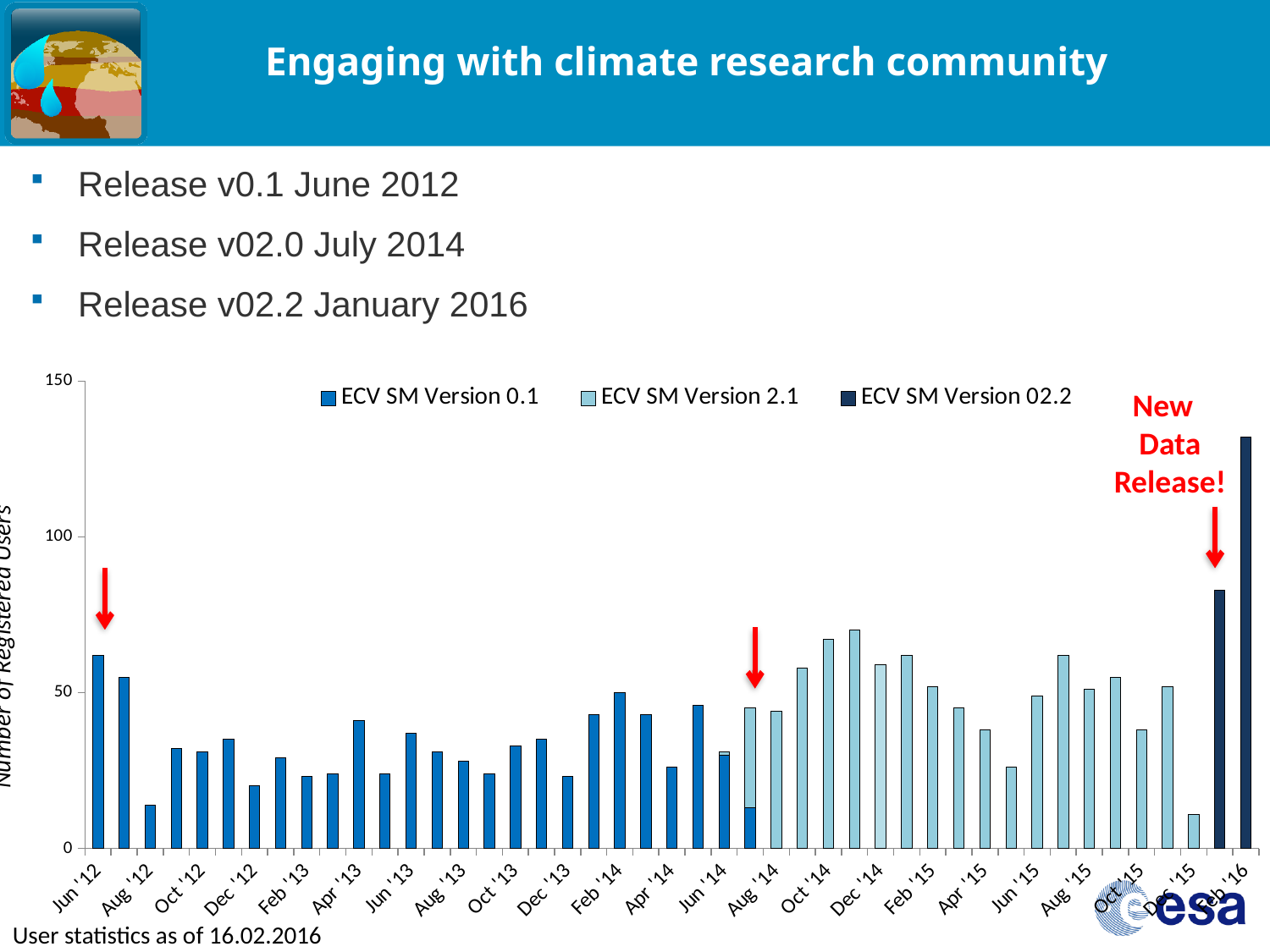
What is the title of the vertical axis of the chart? Number of Registered Users Is the value for Oct '14 greater or less than 50? greater Which series is listed first in the chart legend? ECV SM Version 0.1 Is the value for Aug '12 greater or less than 50? less Is the value for Jun '12 greater or less than 50? greater What kind of chart is shown on the slide? bar chart Which is larger, the value for Jun '12 or the value for Aug '12? Jun '12 Which is larger, the value for Oct '14 or the value for Apr '15? Oct '14 Which month has the highest bar in the chart? Feb '16 How many series does the chart legend list? 3